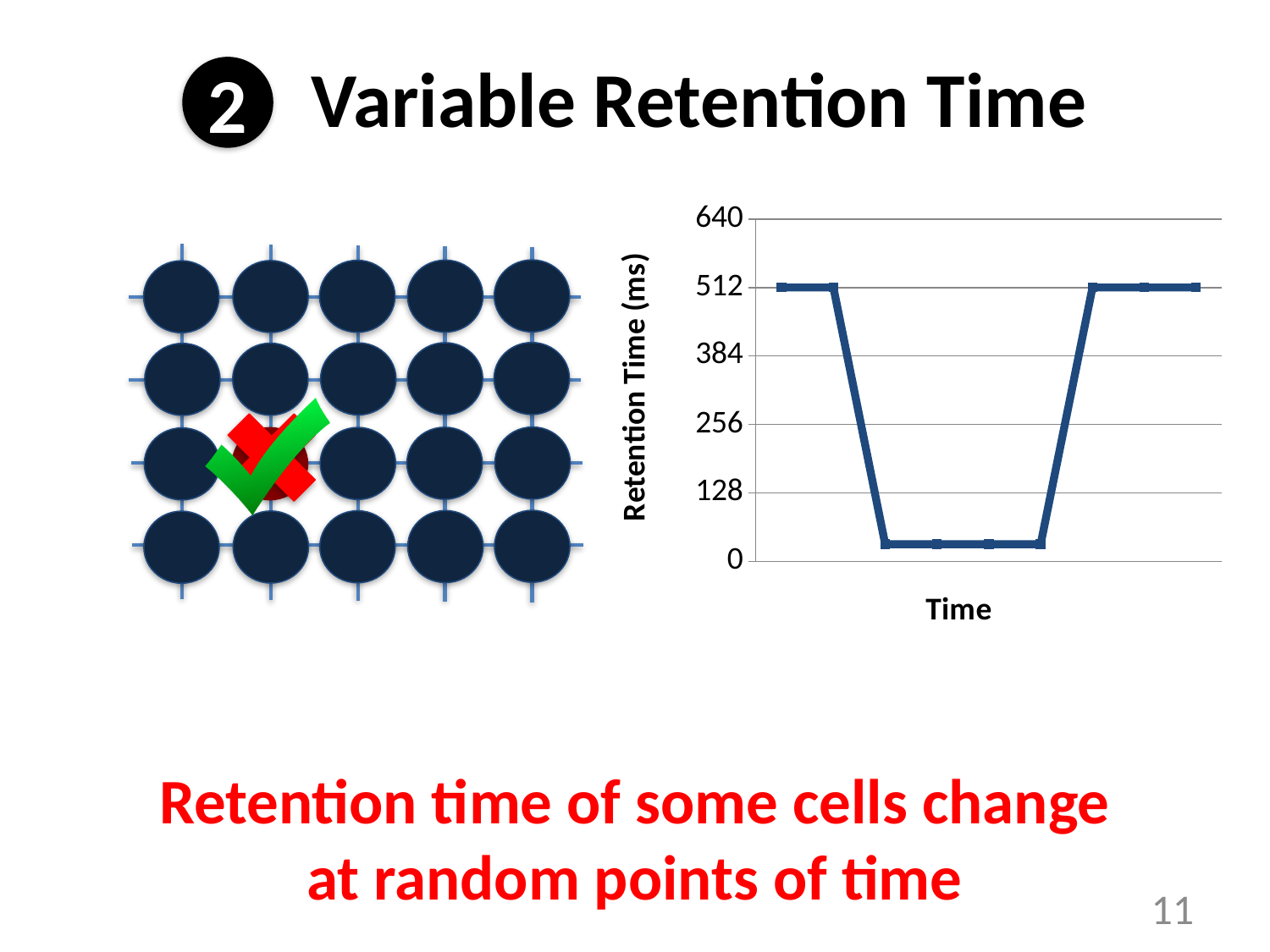
How many data point markers are plotted on the line? 9 What is the label of the x-axis of the chart? Time What is the label of the y-axis of the chart? Retention Time (ms) Is the lowest retention time value on the chart greater or less than 128? less What type of chart is shown on the slide? line chart What is the highest retention time value plotted on the chart? 512 Is the retention time at the start of the chart greater or less than 384? greater At what retention time value does the line end on the right side of the chart? 512 What is the maximum value shown on the y-axis of the chart? 640 How many tick labels are shown on the y-axis? 6 How does the retention time change along the time axis? It falls sharply, stays low, then rises back to 512 Is the retention time at the end of the chart higher or lower than in the middle of the chart? higher